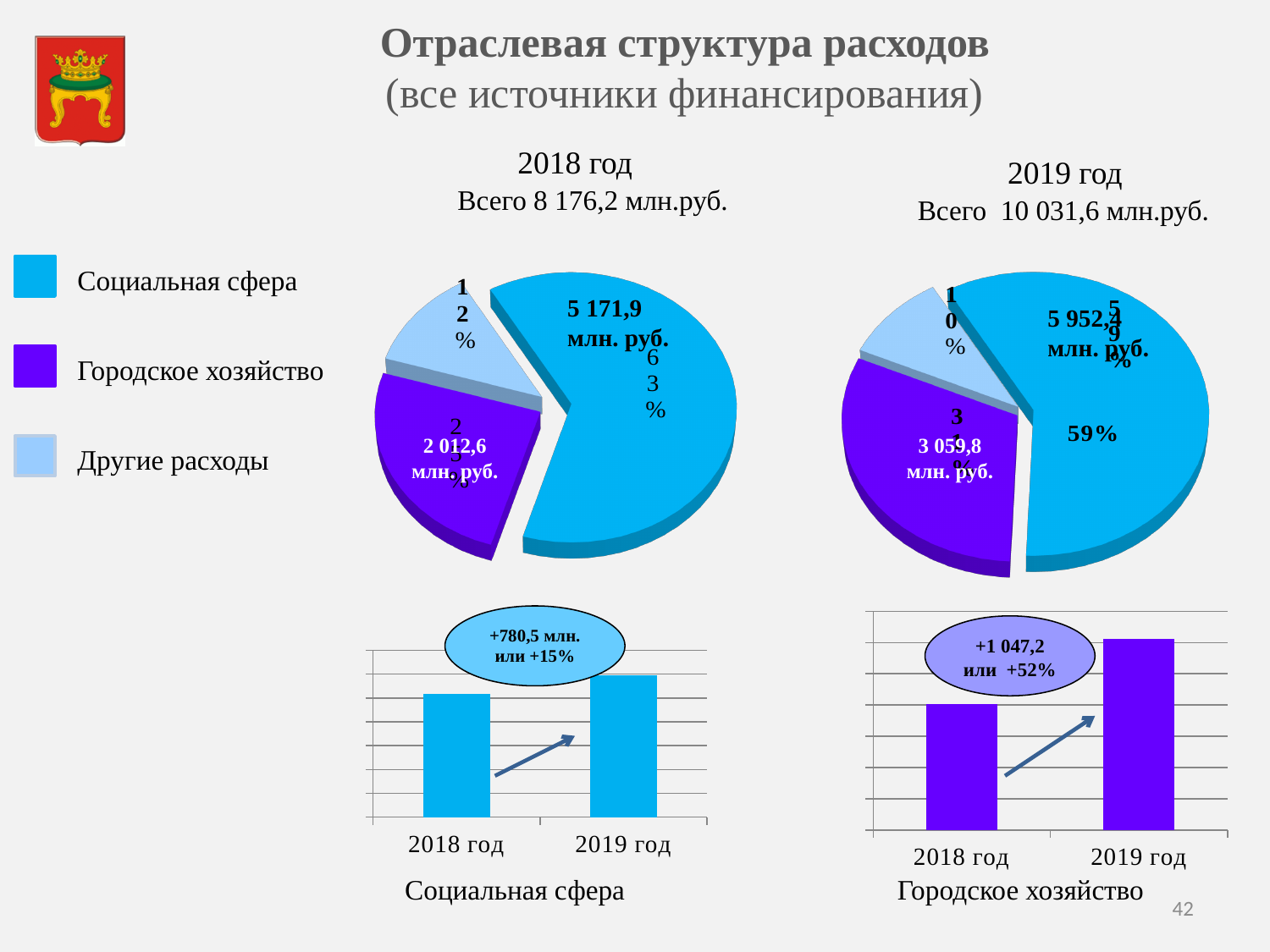
On the 2018 год pie chart, which category has the smallest slice? Другие расходы On the 2018 год pie chart, what share of the pie is Социальная сфера? 63% On the 2018 год pie chart, what is the value shown for Городское хозяйство? 2 012,6 млн. руб. How many categories does the legend on the left of the slide list? 3 On the 2019 год pie chart, which category has the largest slice? Социальная сфера On the 2019 год pie chart, what is the value shown for Городское хозяйство? 3 059,8 млн. руб. On the 2019 год pie chart, what share of the pie is Социальная сфера? 59% What kind of chart is the Городское хозяйство chart at the bottom right of the slide? bar chart On the 2018 год pie chart, what is the value shown for Социальная сфера? 5 171,9 млн. руб. On the Социальная сфера bar chart at the bottom left, do the values rise or fall from 2018 год to 2019 год? rise On the 2019 год pie chart, what share of the pie is Другие расходы? 10%